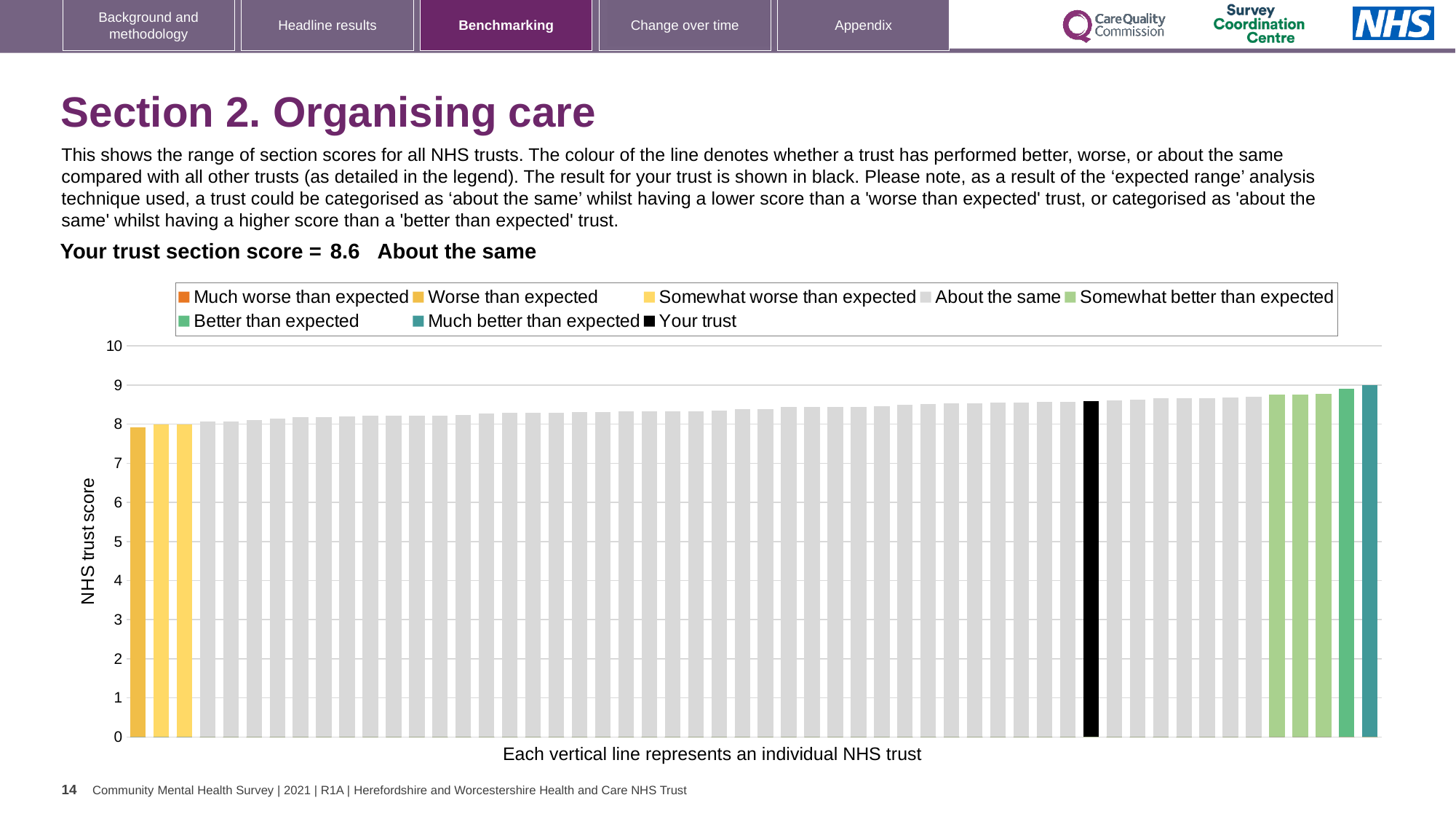
How many entries does the chart legend list? 8 Which performance category is your trust placed in for this section? About the same Which legend category does the tallest bar belong to? Much better than expected Do the bar values rise or fall from left to right along the x axis? rise Is the value of the rightmost (highest) bar greater or less than 10? less How many bars are coloured as 'Much better than expected'? 1 Which legend category does the shortest bar belong to? Worse than expected Is the value of the leftmost (lowest) bar greater or less than 7? greater What is the label on the vertical axis of the chart? NHS trust score Is the value of the black 'Your trust' bar greater or less than 8? greater What kind of chart is shown on the slide? bar chart What is the section score for your trust shown on the slide? 8.6